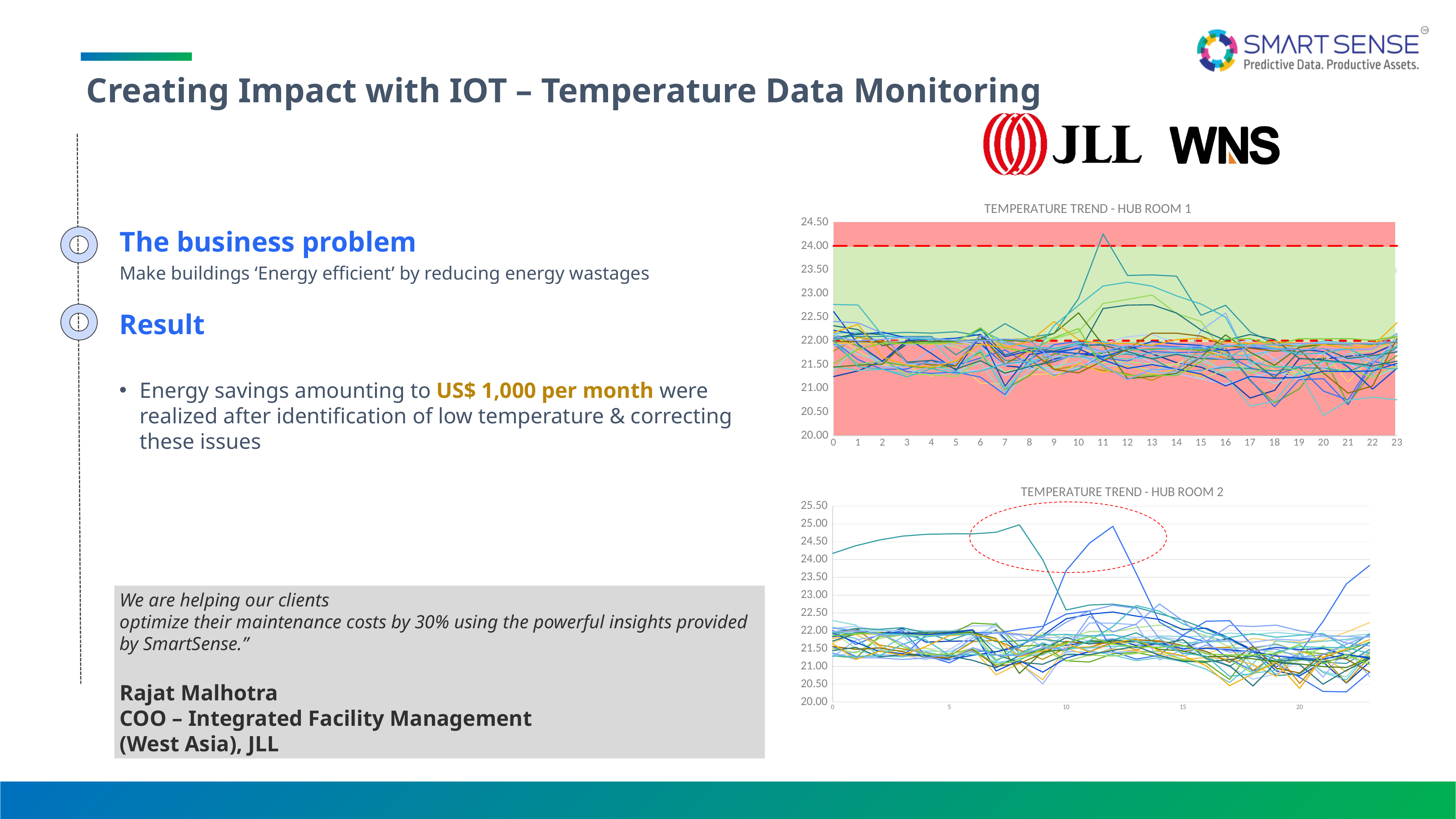
What kind of chart is the TEMPERATURE TREND - HUB ROOM 1 chart? Line chart In the TEMPERATURE TREND - HUB ROOM 1 chart, is the lowest plotted value greater or less than 21.00? less What kind of chart is the TEMPERATURE TREND - HUB ROOM 2 chart? Line chart In the TEMPERATURE TREND - HUB ROOM 2 chart, is the highest plotted value (the peak inside the red dotted ellipse) greater or less than 24.50? greater In the TEMPERATURE TREND - HUB ROOM 1 chart, at which y-axis value is the upper red dashed line drawn? 24.00 In the TEMPERATURE TREND - HUB ROOM 1 chart, what is the highest value shown on the y axis? 24.50 What is the title of the upper chart on the slide? TEMPERATURE TREND - HUB ROOM 1 In the TEMPERATURE TREND - HUB ROOM 2 chart, is the lowest plotted value greater or less than 21.00? less In the TEMPERATURE TREND - HUB ROOM 1 chart, how many points are labelled on the x axis? 24 In the TEMPERATURE TREND - HUB ROOM 2 chart, what is the highest value shown on the y axis? 25.50 In the TEMPERATURE TREND - HUB ROOM 2 chart, what is the lowest value shown on the y axis? 20.00